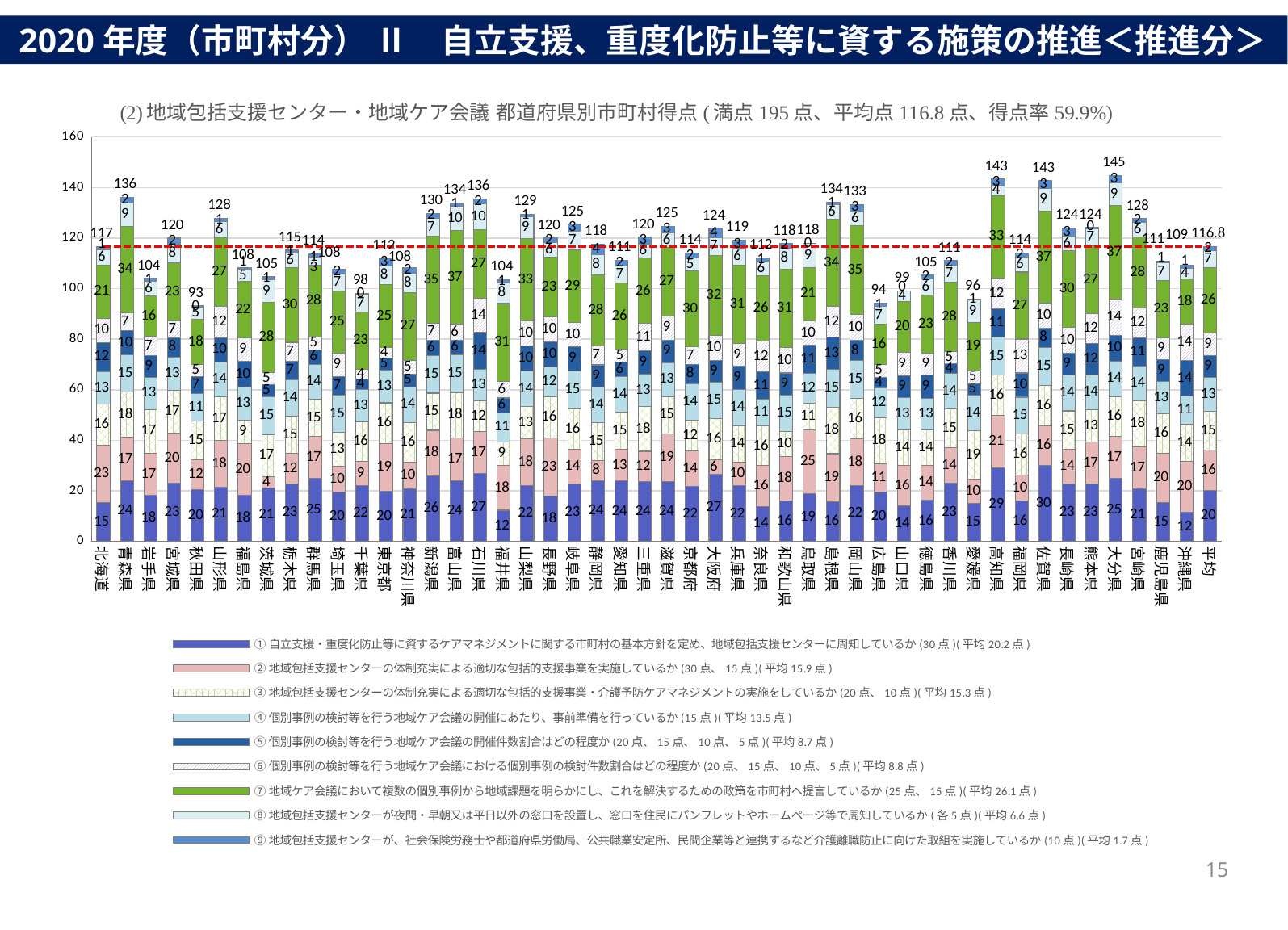
What is the total score shown above the bar for 大分県? 145 How many series does the legend list? 9 Which prefecture has the highest total score? 大分県 What value does the red dashed horizontal line represent, according to the chart title? 平均点 116.8 点 What kind of chart is shown on the slide? Stacked bar chart What is the total score shown above the bar for 青森県? 136 What is the total score shown for 平均 (the average bar)? 116.8 What is the value of the bottom segment (series ①) for 佐賀県? 30 Which prefecture has the lowest total score? 秋田県 Is the total score for 石川県 greater or less than 120? greater What is the difference between the total scores of 大分県 and 秋田県? 52 Which has a higher total score, 高知県 or 岡山県? 高知県